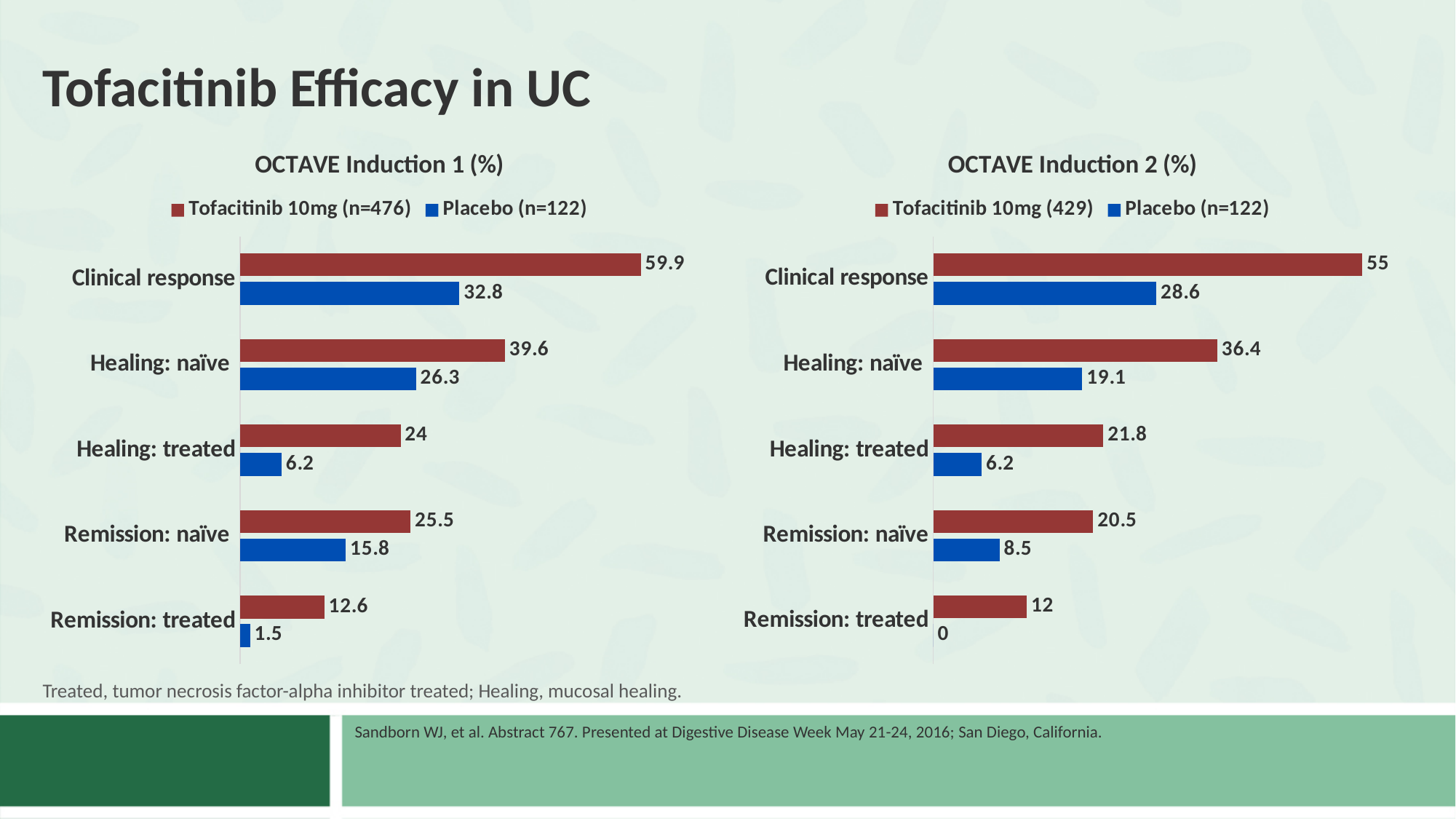
In the OCTAVE Induction 2 (%) chart, which category has the highest Tofacitinib 10mg value? Clinical response How many series does the legend of the OCTAVE Induction 1 (%) chart list? 2 In the OCTAVE Induction 2 (%) chart, what is the difference between the Tofacitinib 10mg and Placebo values for Healing: treated? 15.6 In the OCTAVE Induction 1 (%) chart, which category has the lowest Placebo value? Remission: treated In the OCTAVE Induction 2 (%) chart, what colour are the Placebo bars? Blue In the OCTAVE Induction 1 (%) chart, what is the difference between the Tofacitinib 10mg and Placebo values for Clinical response? 27.1 In the OCTAVE Induction 2 (%) chart, what is the Placebo value for Remission: treated? 0 What kind of chart is the OCTAVE Induction 1 (%) chart? Bar chart In the OCTAVE Induction 1 (%) chart, what is the value for Tofacitinib 10mg for Clinical response? 59.9 How many categories are shown in the OCTAVE Induction 2 (%) chart? 5 In the OCTAVE Induction 2 (%) chart, what is the value for Placebo for Healing: naïve? 19.1 In the OCTAVE Induction 1 (%) chart, which is larger: the Tofacitinib 10mg value for Healing: treated or the Tofacitinib 10mg value for Remission: naïve? Remission: naïve